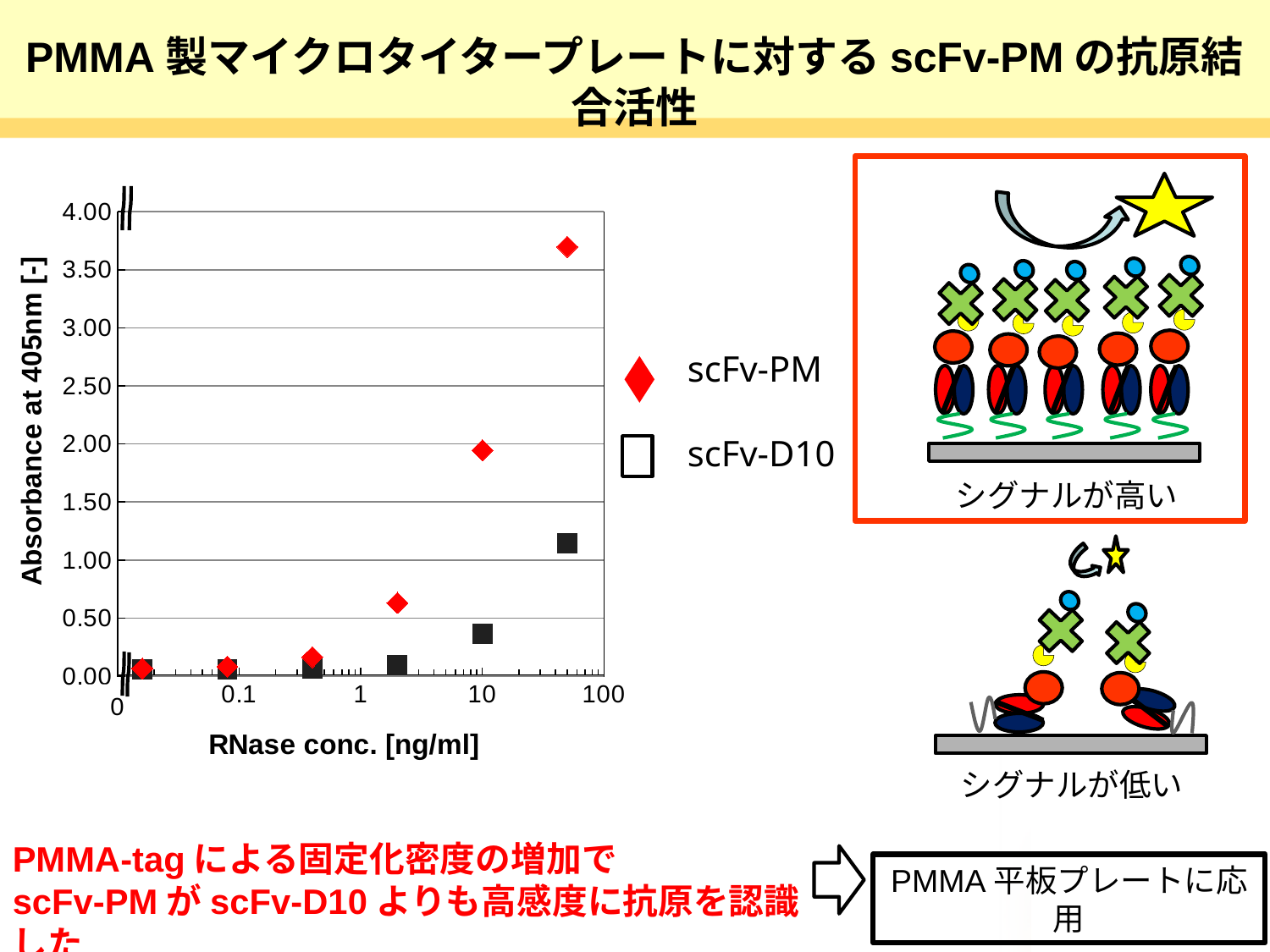
Is the absorbance of scFv-PM at 10 ng/ml RNase greater or less than 1.50? greater What are the two series named in the chart legend? scFv-PM and scFv-D10 Is the absorbance of scFv-D10 at its highest plotted RNase concentration greater or less than 1.00? greater How many series does the chart legend list? 2 Does the absorbance of scFv-PM rise or fall as the RNase concentration increases along the x axis? rise What is the label of the y axis of the chart? Absorbance at 405nm [-] At the highest RNase concentration plotted, which series has the larger absorbance, scFv-PM or scFv-D10? scFv-PM Is the absorbance of scFv-D10 at 10 ng/ml RNase greater or less than 0.50? less What kind of chart is shown on the slide? Scatter plot How many data points are plotted for the scFv-PM series? 6 Which series reaches the highest absorbance on the chart? scFv-PM